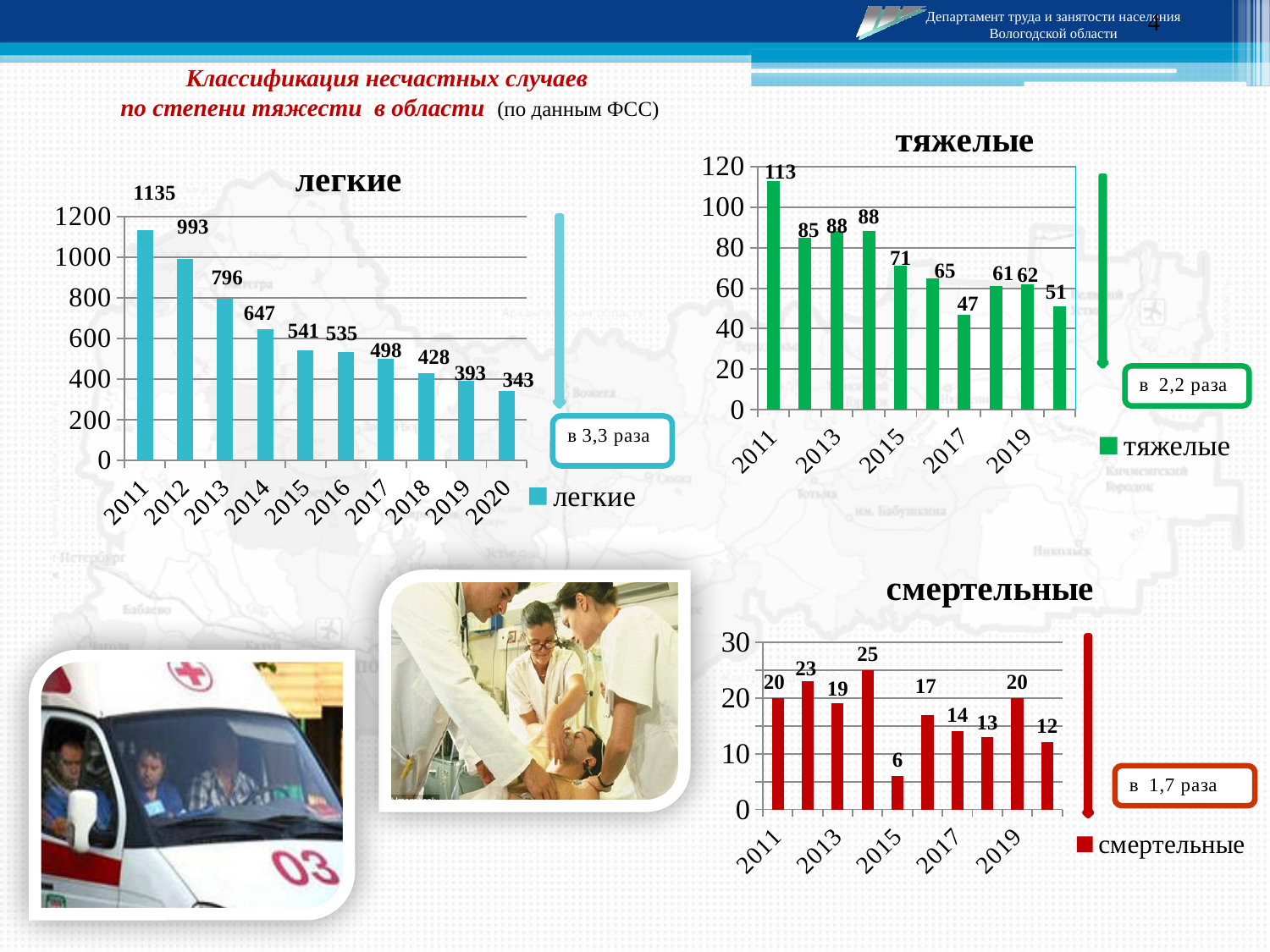
In the 'смертельные' chart, which is larger, the value for 2013 or the value for 2017? 2013 In the 'легкие' chart, what is the value for 2011? 1135 In the 'легкие' chart, how many years are plotted? 10 In the 'легкие' chart, what is the value for 2020? 343 In the 'легкие' chart, what is the difference between the values for 2011 and 2020? 792 In the 'тяжелые' chart, what is the value for 2011? 113 In the 'смертельные' chart, which year has the lowest value? 2015 In the 'тяжелые' chart, which year has the highest value? 2011 In the 'тяжелые' chart, what is the value for 2017? 47 In the 'легкие' chart, do the values rise or fall from 2011 to 2020? fall In the 'смертельные' chart, what is the value for 2019? 20 What kind of chart is the 'смертельные' chart? bar chart